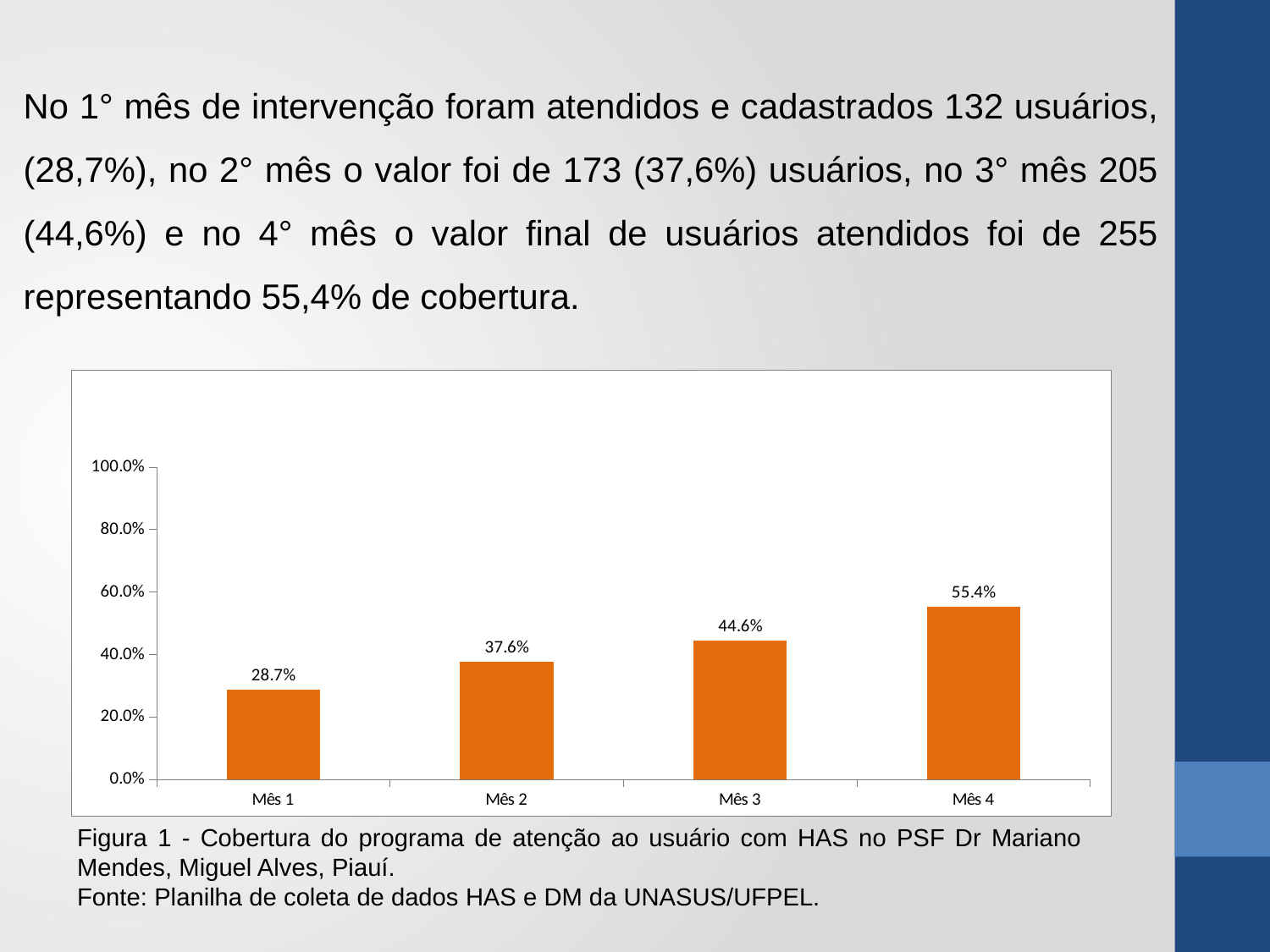
What is the value for Mês 2? 37.6% What is the value for Mês 1? 28.7% Which month has the lowest value? Mês 1 Do the values rise or fall from Mês 1 to Mês 4? Rise What kind of chart is this? Bar chart What is the difference between the values for Mês 3 and Mês 2? 7.0% What is the value for Mês 3? 44.6% What is the difference between the values for Mês 4 and Mês 1? 26.7% Which is larger, the value for Mês 2 or the value for Mês 3? Mês 3 How many categories are shown on the x axis? 4 Which month has the highest value? Mês 4 What is the value for Mês 4? 55.4%